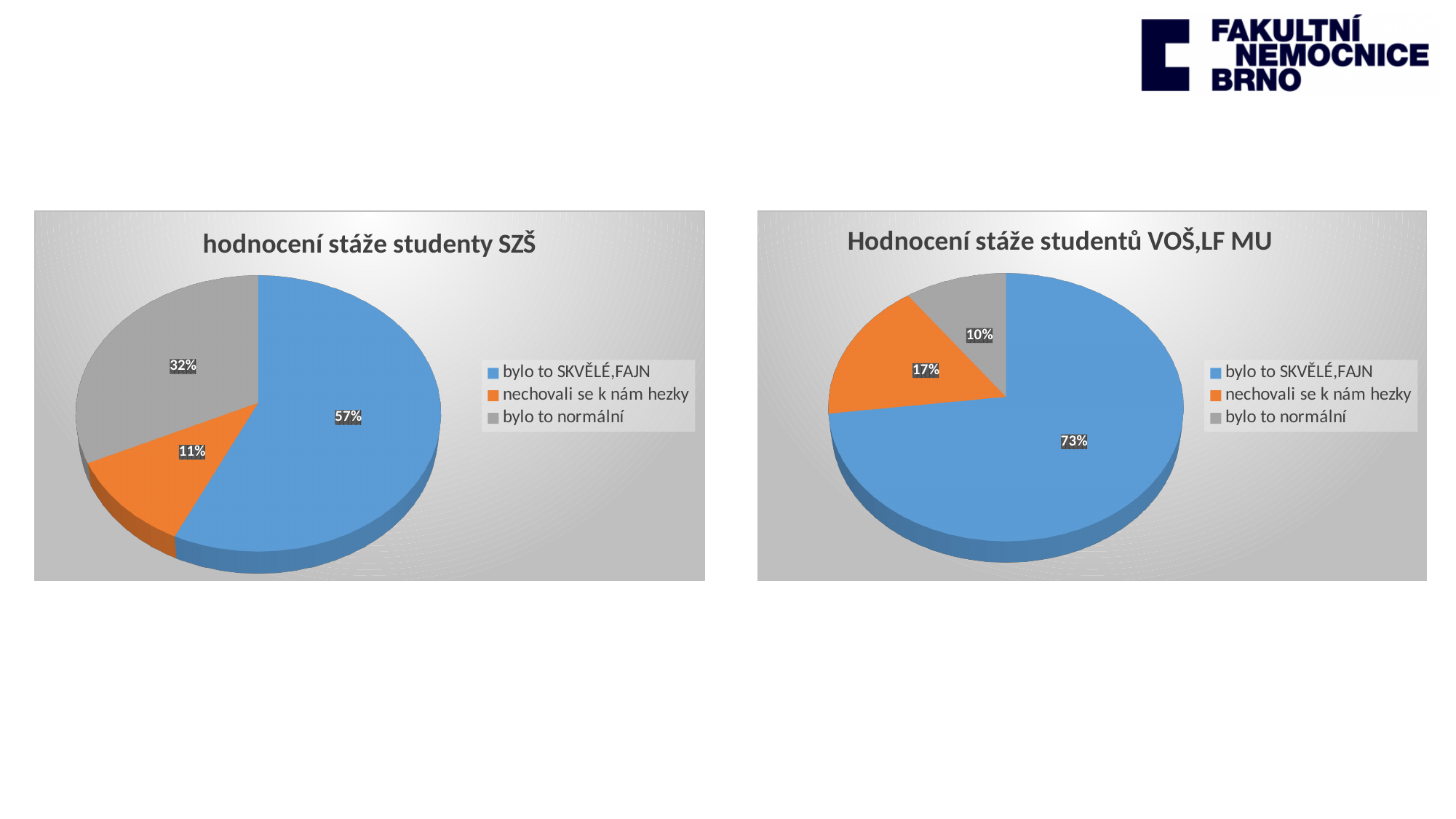
How many categories does the legend of the chart titled "Hodnocení stáže studentů VOŠ,LF MU" list? 3 In the chart titled "Hodnocení stáže studentů VOŠ,LF MU", what percentage is shown for "bylo to SKVĚLÉ,FAJN"? 73% In the chart titled "hodnocení stáže studenty SZŠ", what percentage is shown for "nechovali se k nám hezky"? 11% In the chart titled "Hodnocení stáže studentů VOŠ,LF MU", what percentage is shown for "nechovali se k nám hezky"? 17% Which chart shows a larger share for "bylo to SKVĚLÉ,FAJN", the left chart (SZŠ) or the right chart (VOŠ,LF MU)? the right chart (VOŠ,LF MU) In the chart titled "Hodnocení stáže studentů VOŠ,LF MU", which category has the largest slice? bylo to SKVĚLÉ,FAJN In the chart titled "hodnocení stáže studenty SZŠ", what percentage is shown for "bylo to normální"? 32% In the chart titled "hodnocení stáže studenty SZŠ", what percentage is shown for "bylo to SKVĚLÉ,FAJN"? 57% What type of chart is the chart titled "hodnocení stáže studenty SZŠ"? pie chart In the chart titled "hodnocení stáže studenty SZŠ", which category has the smallest slice? nechovali se k nám hezky In the chart titled "Hodnocení stáže studentů VOŠ,LF MU", what percentage is shown for "bylo to normální"? 10% In the chart titled "hodnocení stáže studenty SZŠ", what is the difference in percentage points between "bylo to SKVĚLÉ,FAJN" and "bylo to normální"? 25